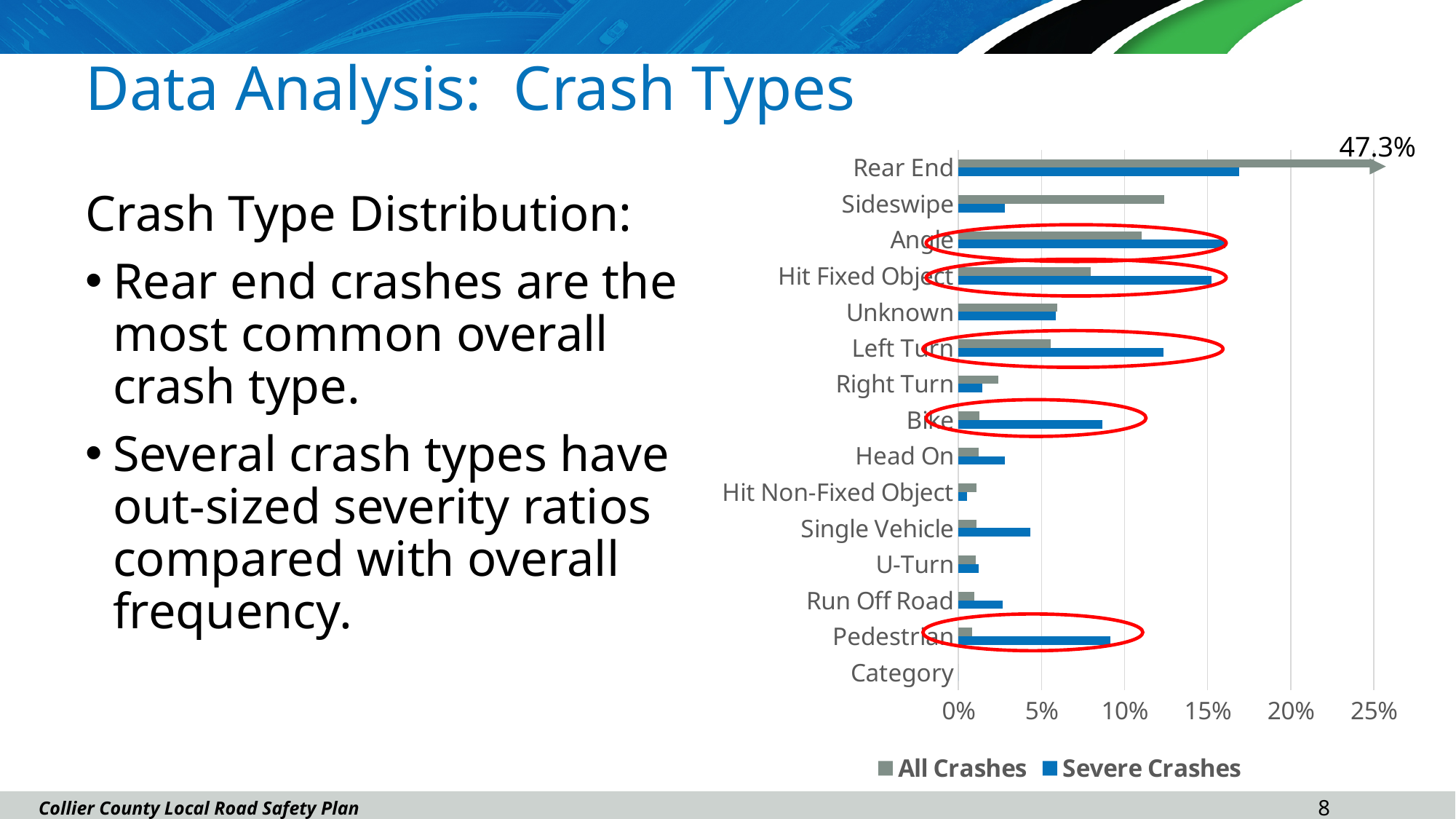
For Pedestrian, which is larger: All Crashes or Severe Crashes? Severe Crashes Which colour represents Severe Crashes in the chart? Blue Is the Severe Crashes value for Left Turn greater or less than 10%? greater For Sideswipe, which is larger: All Crashes or Severe Crashes? All Crashes What kind of chart is shown on the slide? Bar chart Is the Severe Crashes value for Rear End greater or less than 15%? greater Which crash type has the highest All Crashes value? Rear End Is the All Crashes value for Pedestrian greater or less than 5%? less What is the All Crashes value for Rear End? 47.3% How many series does the legend list? 2